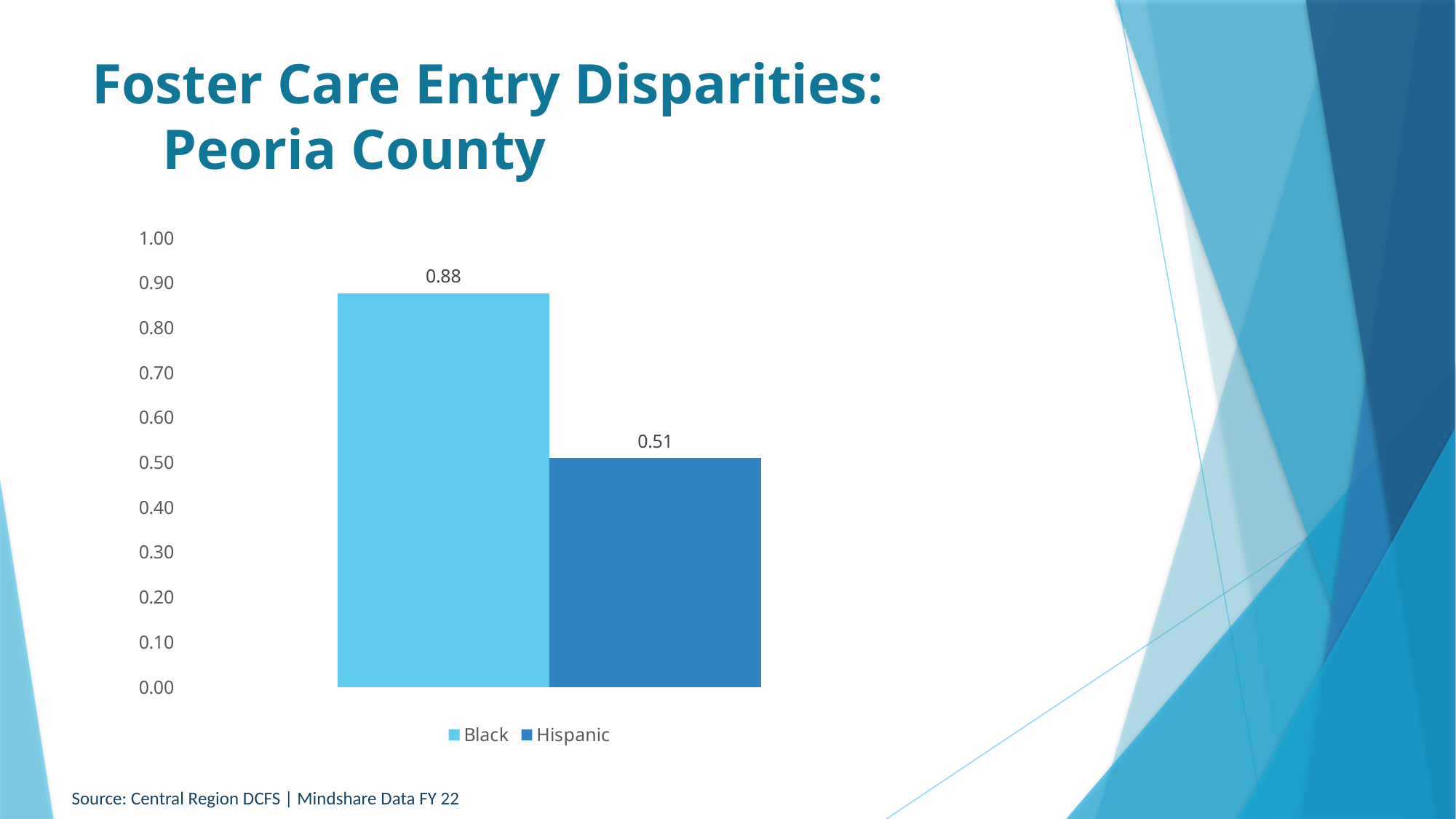
Which is larger, the value for Black or the value for Hispanic? Black Which series has the lowest value? Hispanic Which series has the highest value? Black What is the maximum value shown on the vertical axis? 1.00 What is the title of the slide? Foster Care Entry Disparities: Peoria County What kind of chart is shown on the slide? bar chart How many series does the legend list? 2 Is the value for Black greater or less than 0.80? greater What is the difference between the values for Black and Hispanic? 0.37 What is the value for Hispanic? 0.51 What is the value for Black? 0.88 Is the value for Hispanic greater or less than 0.60? less